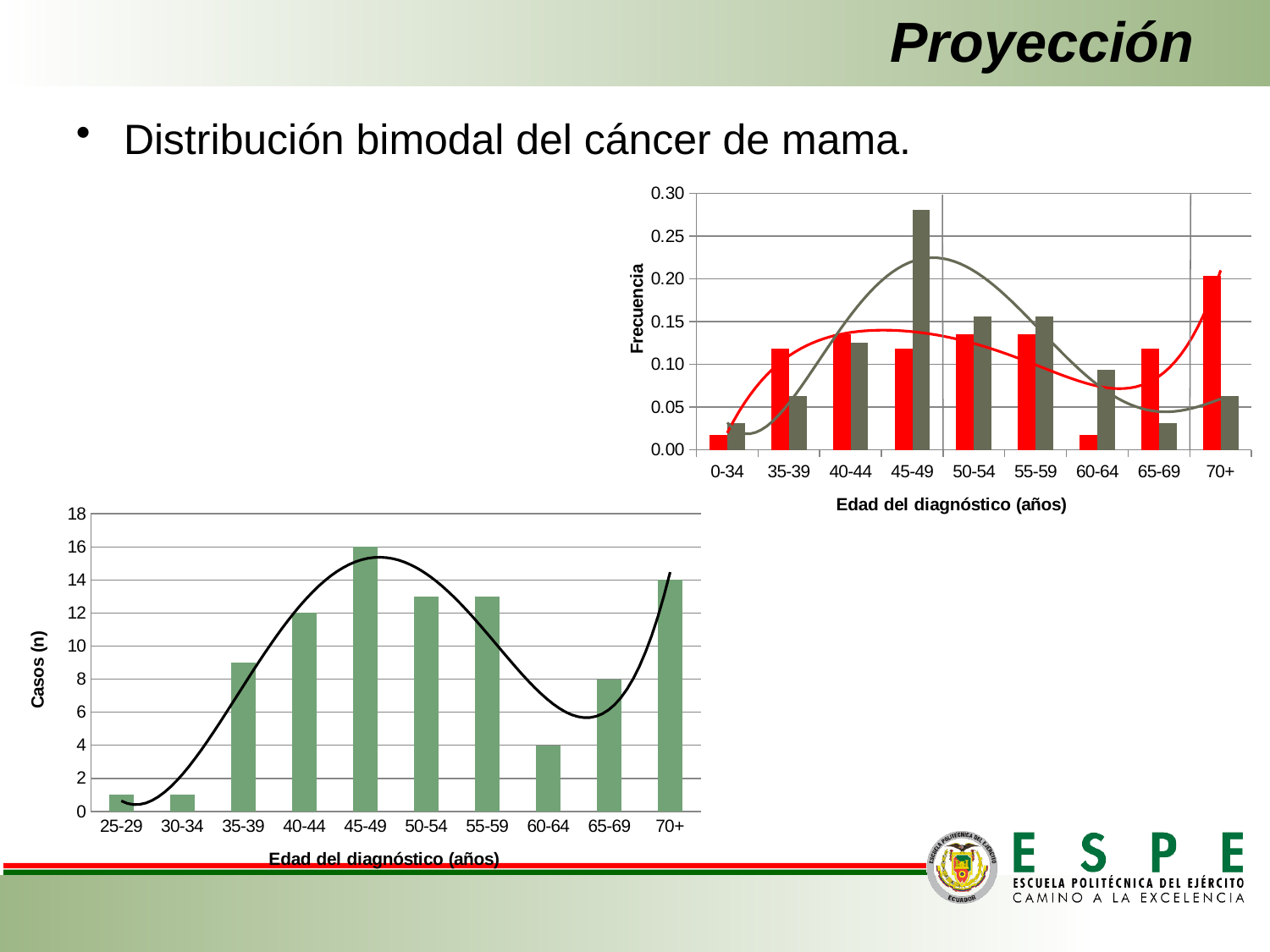
In the bottom-left chart (Casos (n)), is the value for 35-39 greater or less than 10? less In the bottom-left chart (Casos (n)), which is larger, the value for 45-49 or the value for 70+? 45-49 In the bottom-left chart (Casos (n)), which age group has the highest number of cases? 45-49 In the top-right chart (Frecuencia), is the red bar for 60-64 greater or less than 0.05? less What kind of chart is the bottom-left chart (Casos (n))? bar chart In the bottom-left chart (Casos (n)), what is the difference between the values for 45-49 and 40-44? 4 In the bottom-left chart (Casos (n)), what is the value for the 45-49 age group? 16 In the bottom-left chart (Casos (n)), what is the value for the 60-64 age group? 4 How many age groups are shown on the x axis of the top-right chart (Frecuencia)? 9 In the top-right chart (Frecuencia), is the grey bar for 45-49 greater or less than 0.25? greater In the bottom-left chart (Casos (n)), what is the value for the 70+ age group? 14 How many age groups are shown on the x axis of the bottom-left chart (Casos (n))? 10